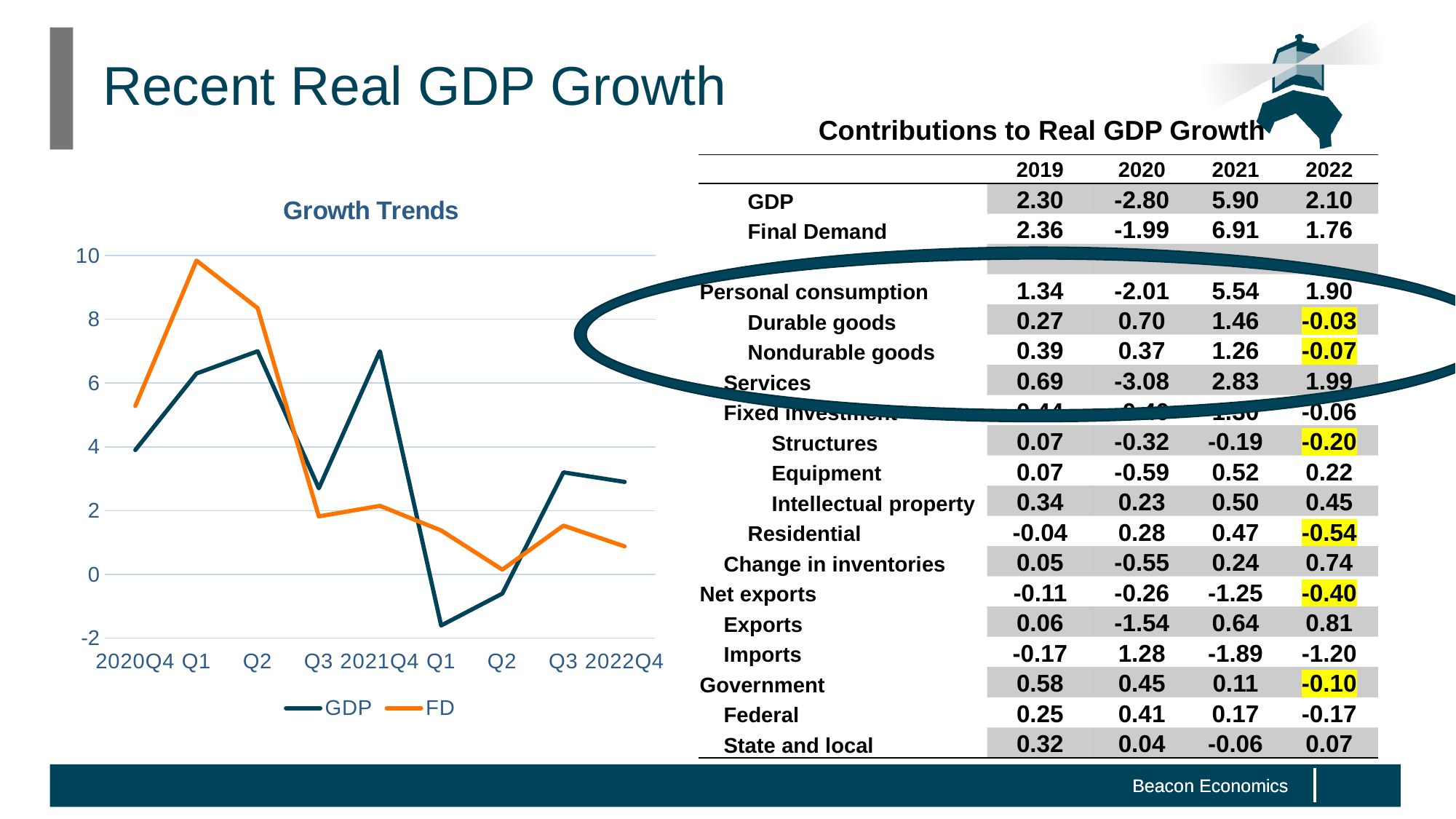
What kind of chart is the "Growth Trends" chart? line chart In the "Growth Trends" chart, is the GDP value at Q1 2022 greater or less than 0? less How many quarters are plotted along the x axis of the "Growth Trends" chart? 9 In the "Growth Trends" chart, is the GDP value at 2021Q4 greater or less than 6? greater In the "Growth Trends" chart, at which quarter does the GDP line reach its lowest value? Q1 (2022) How many series does the legend of the "Growth Trends" chart list? 2 In the "Growth Trends" chart, does the GDP line rise or fall from Q1 2022 to Q3 2022? rise What are the two series named in the legend of the "Growth Trends" chart? GDP and FD In the "Growth Trends" chart, which series has the larger value at Q1 2021, GDP or FD? FD In the "Growth Trends" chart, is the FD value at Q1 2021 greater or less than 8? greater In the "Growth Trends" chart, which series has the larger value at 2021Q4, GDP or FD? GDP In the "Growth Trends" chart, at which quarter does the FD line reach its highest value? Q1 (2021)